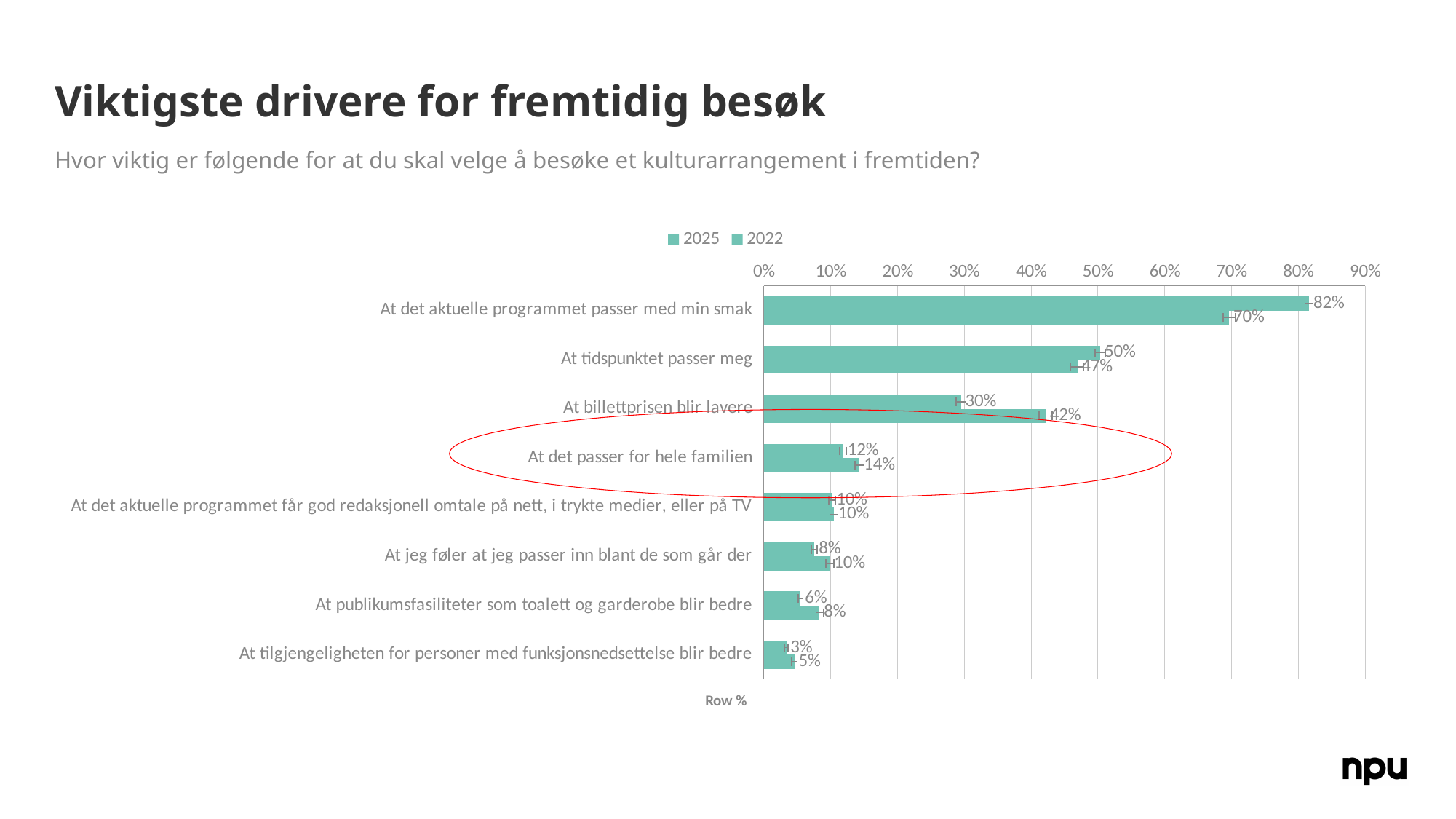
Which category has the lowest 2022 value? At tilgjengeligheten for personer med funksjonsnedsettelse blir bedre Which category has the highest 2025 value? At det aktuelle programmet passer med min smak Which series is listed first in the legend? 2025 How many series does the legend list? 2 What is the 2025 value for 'At det aktuelle programmet passer med min smak'? 70% What is the 2022 value for 'At det aktuelle programmet passer med min smak'? 82% What is the difference between the 2022 and 2025 values for 'At billettprisen blir lavere'? 12% How many categories are shown on the chart? 8 What is the 2025 value for 'At billettprisen blir lavere'? 42% For 'At tidspunktet passer meg', which is larger, the 2025 value or the 2022 value? 2022 What is the 2022 value for 'At det passer for hele familien'? 12% What kind of chart is shown on the slide? bar chart